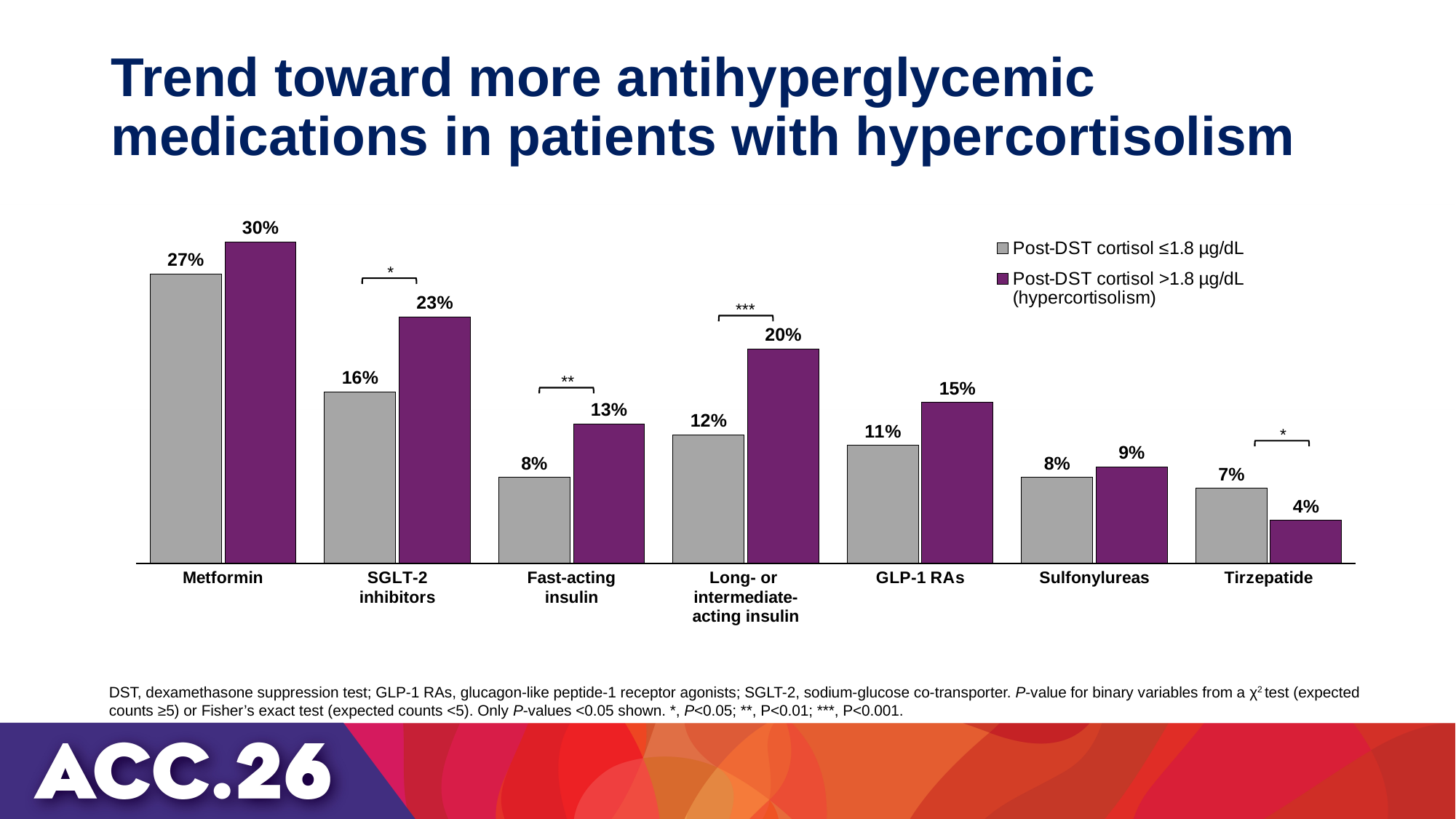
For Fast-acting insulin, which series has the larger value? Post-DST cortisol >1.8 µg/dL (hypercortisolism) How many medication categories are shown on the x axis? 7 How many series does the legend list? 2 Which medication category has the lowest value in the Post-DST cortisol >1.8 µg/dL (hypercortisolism) series? Tirzepatide What is the value for Metformin in the Post-DST cortisol >1.8 µg/dL (hypercortisolism) series? 30% What kind of chart is shown on the slide? Bar chart Which medication category has the highest value in the Post-DST cortisol ≤1.8 µg/dL series? Metformin What is the difference between the two series for SGLT-2 inhibitors? 7% What is the value for SGLT-2 inhibitors in the Post-DST cortisol ≤1.8 µg/dL series? 16% What is the difference between the two series for Long- or intermediate-acting insulin? 8% What is the value for Tirzepatide in the Post-DST cortisol >1.8 µg/dL (hypercortisolism) series? 4% For Tirzepatide, which series has the larger value? Post-DST cortisol ≤1.8 µg/dL